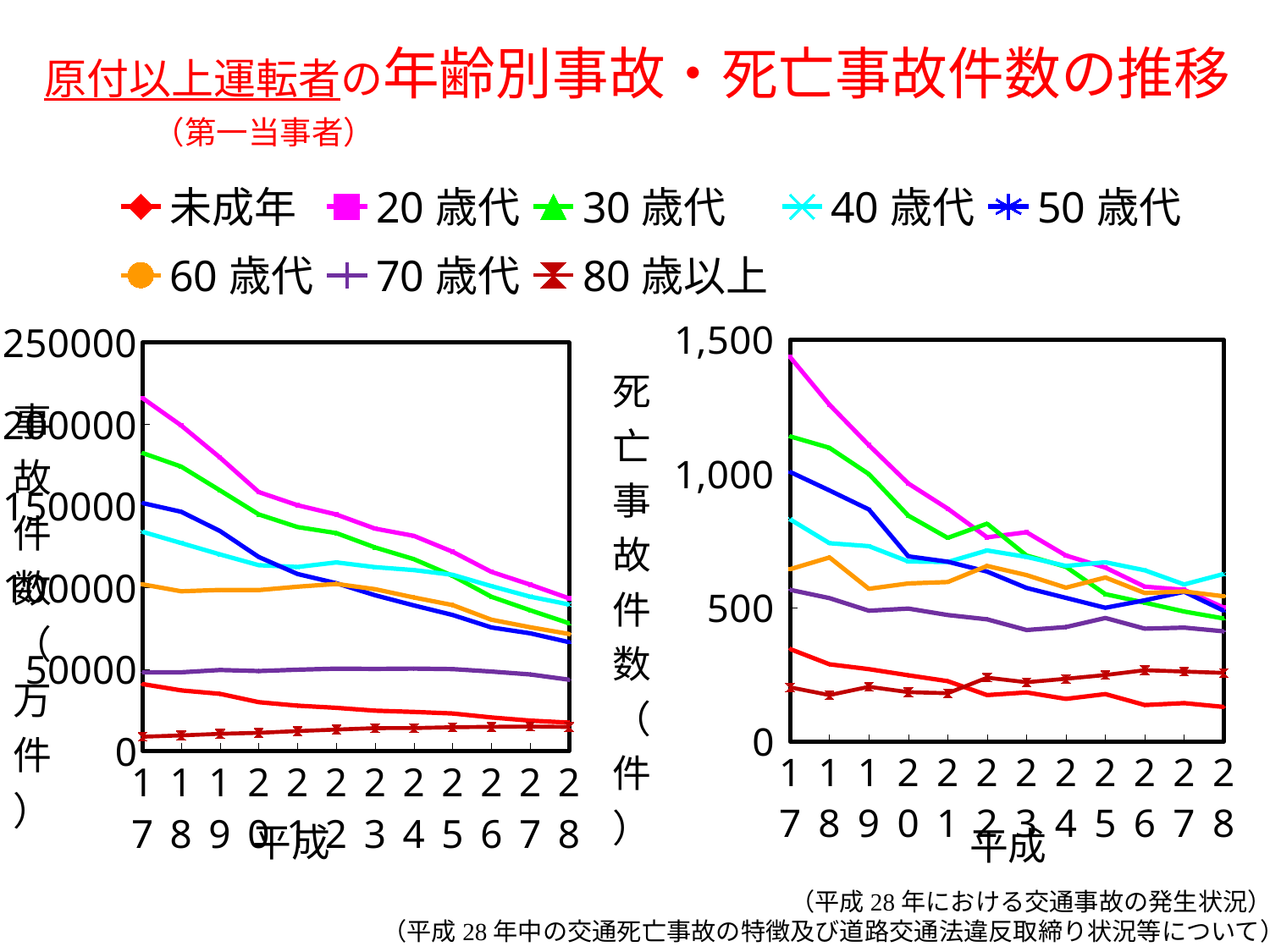
In the left chart (事故件数), which age group has the highest value at 平成17? 20歳代 In the left chart (事故件数), which is larger at 平成17: 30歳代 or 40歳代? 30歳代 How many series does the legend list? 8 In the right chart (死亡事故件数), does the 20歳代 series rise or fall from 平成17 to 平成28? fall In the left chart (事故件数), is the value for 20歳代 at 平成17 greater or less than 200000? greater How many years (points) are plotted along the x axis of the right chart (死亡事故件数)? 12 In the left chart (事故件数), which age group has the lowest value at 平成17? 80歳以上 In the right chart (死亡事故件数), which age group has the lowest value at 平成28? 未成年 In the right chart (死亡事故件数), is the value for 80歳以上 at 平成28 greater or less than 500? less In the right chart (死亡事故件数), which age group has the highest value at 平成17? 20歳代 What is the x-axis label shown under both charts? 平成 What kind of chart is the left chart (事故件数)? line chart